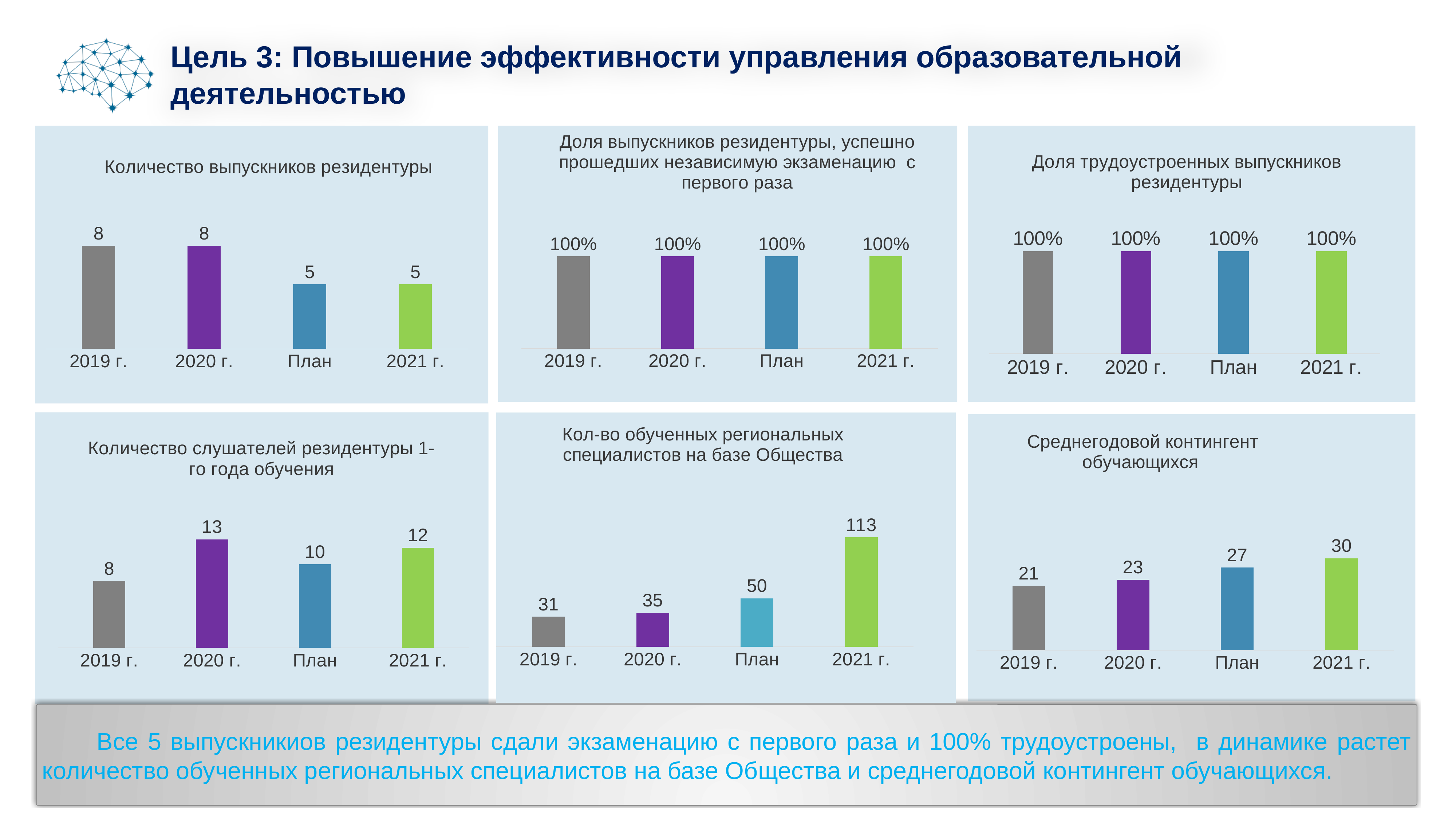
In the chart 'Среднегодовой контингент обучающихся', which is larger, the value for План or the value for 2021 г.? 2021 г. In the chart 'Доля выпускников резидентуры, успешно прошедших независимую экзаменацию с первого раза', what is the value for План? 100% In the chart 'Количество слушателей резидентуры 1-го года обучения', which category has the highest value? 2020 г. In the chart 'Количество слушателей резидентуры 1-го года обучения', what is the value for План? 10 In the chart 'Кол-во обученных региональных специалистов на базе Общества', what is the value for 2021 г.? 113 In the chart 'Кол-во обученных региональных специалистов на базе Общества', do the values rise or fall from 2019 г. to 2021 г.? rise What type of chart is 'Среднегодовой контингент обучающихся'? bar chart In the chart 'Кол-во обученных региональных специалистов на базе Общества', what is the difference between the 2021 г. value and the План value? 63 In the chart 'Количество выпускников резидентуры', what is the value for 2021 г.? 5 In the chart 'Количество выпускников резидентуры', what is the difference between the 2019 г. value and the План value? 3 In the chart 'Доля трудоустроенных выпускников резидентуры', how many categories are shown on the x axis? 4 In the chart 'Среднегодовой контингент обучающихся', which category has the lowest value? 2019 г.